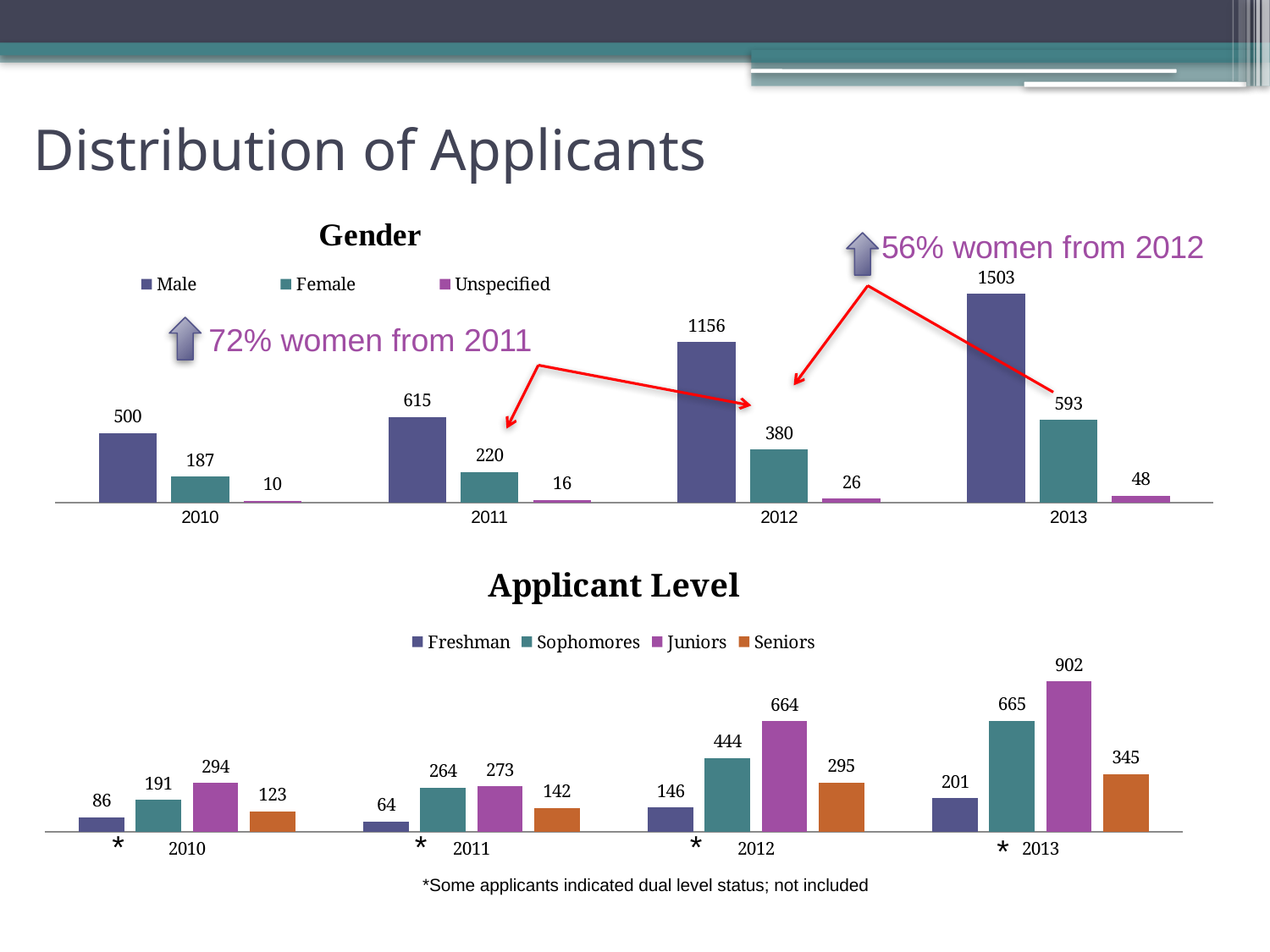
In the Gender chart, which year has the highest Unspecified value? 2013 In the Gender chart, how many series does the legend list? 3 In the Gender chart, what is the value for Female in 2011? 220 In the Applicant Level chart, which level has the lowest value in 2012? Freshman In the Gender chart, what is the difference between Male and Female in 2012? 776 In the Applicant Level chart, what is the value for Freshman in 2011? 64 In the Gender chart, do the Female values rise or fall from 2010 to 2013? rise In the Applicant Level chart, how many years are shown on the x axis? 4 In the Applicant Level chart, what is the value for Juniors in 2013? 902 In the Gender chart, what is the value for Male in 2013? 1503 In the Applicant Level chart, which is larger in 2011, Sophomores or Seniors? Sophomores What type of chart is the Applicant Level chart? bar chart